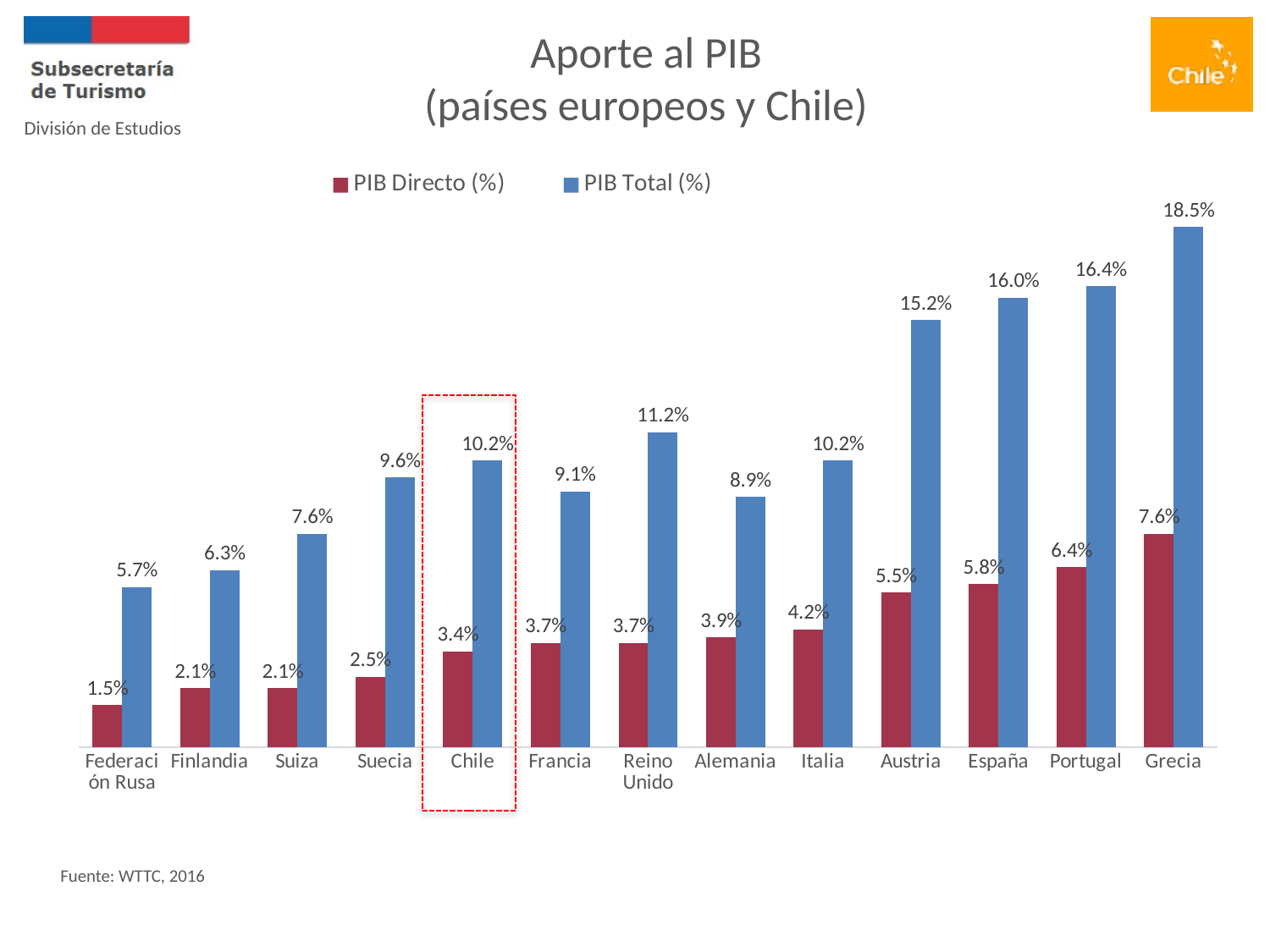
What is the difference between the PIB Total (%) and PIB Directo (%) values for Grecia? 10.9% Do the PIB Total (%) values generally rise or fall from left to right along the x axis? Rise Which is larger, the PIB Total (%) for Reino Unido or for Francia? Reino Unido How many countries are shown on the x axis? 13 Which country has the lowest PIB Directo (%)? Federación Rusa How many series does the legend list? 2 What is the PIB Directo (%) value for Austria? 5.5% What is the PIB Total (%) value for Chile? 10.2% Which country is highlighted with a red dashed box on the chart? Chile What kind of chart is shown on the slide? Bar chart What is the PIB Directo (%) value for Portugal? 6.4% Which country has the highest PIB Total (%)? Grecia